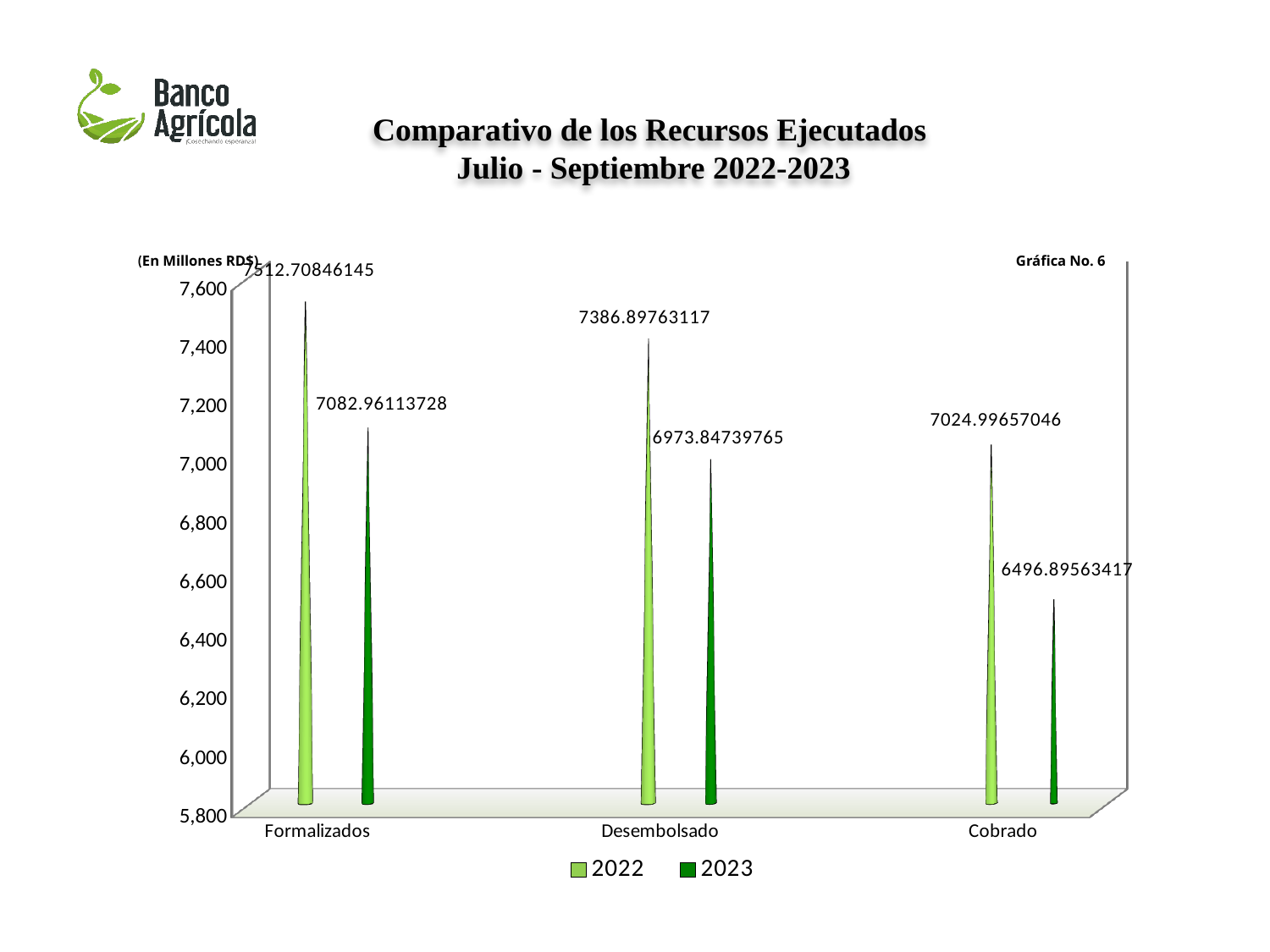
Do the 2023 values rise or fall from Formalizados to Cobrado? fall What kind of chart is shown on the slide? bar chart What is the value for Formalizados in 2023? 7082.96113728 Which is larger for Desembolsado: the 2022 value or the 2023 value? 2022 What is the value for Cobrado in 2022? 7024.99657046 How many series does the legend list? 2 What is the value for Desembolsado in 2022? 7386.89763117 Which category has the highest value for the 2022 series? Formalizados Which category has the lowest value for the 2023 series? Cobrado What is the difference between the 2022 and 2023 values for Cobrado? 528.10093629 What is the value for Cobrado in 2023? 6496.89563417 How many categories are shown on the x axis of the chart? 3